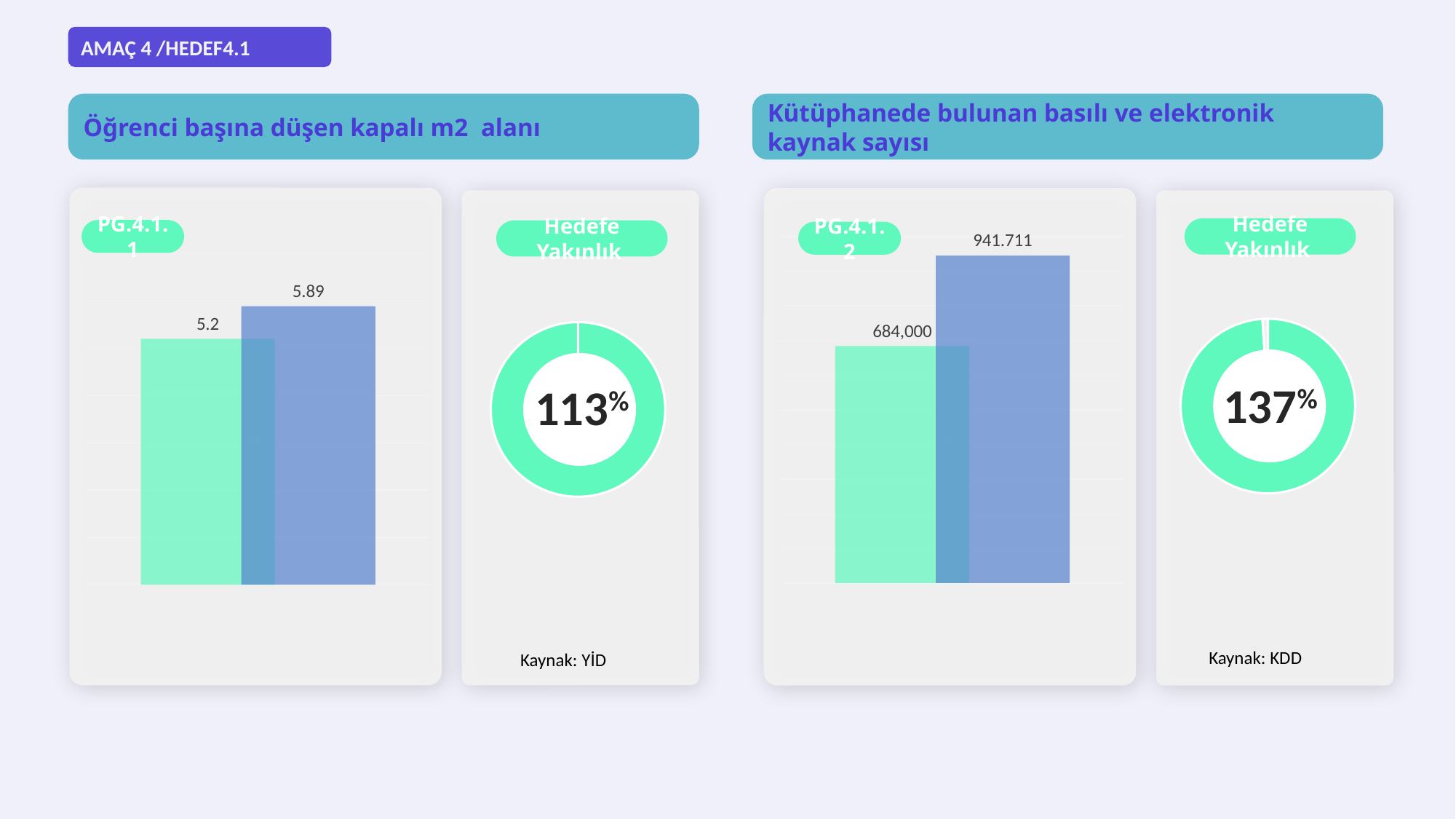
What percentage is shown in the centre of the Hedefe Yakınlık donut chart under 'Öğrenci başına düşen kapalı m2 alanı'? 113% On the PG.4.1.1 bar chart, which bar is taller, the green one or the blue one? the blue one On the PG.4.1.1 bar chart, what value is printed on the green bar? 5.2 On the PG.4.1.2 bar chart, what value is printed on the green bar? 684,000 On the PG.4.1.2 bar chart, which bar is taller, the green one or the blue one? the blue one What kind of chart is used for the Hedefe Yakınlık indicators? donut chart On the PG.4.1.2 bar chart, what value is printed on the blue bar? 941.711 On the PG.4.1.1 bar chart, how many bars are plotted? 2 What source is cited below the Hedefe Yakınlık donut chart on the right side of the slide? Kaynak: KDD What kind of chart is the PG.4.1.2 chart? bar chart On the PG.4.1.1 bar chart, what value is printed on the blue bar? 5.89 What percentage is shown in the centre of the Hedefe Yakınlık donut chart under 'Kütüphanede bulunan basılı ve elektronik kaynak sayısı'? 137%